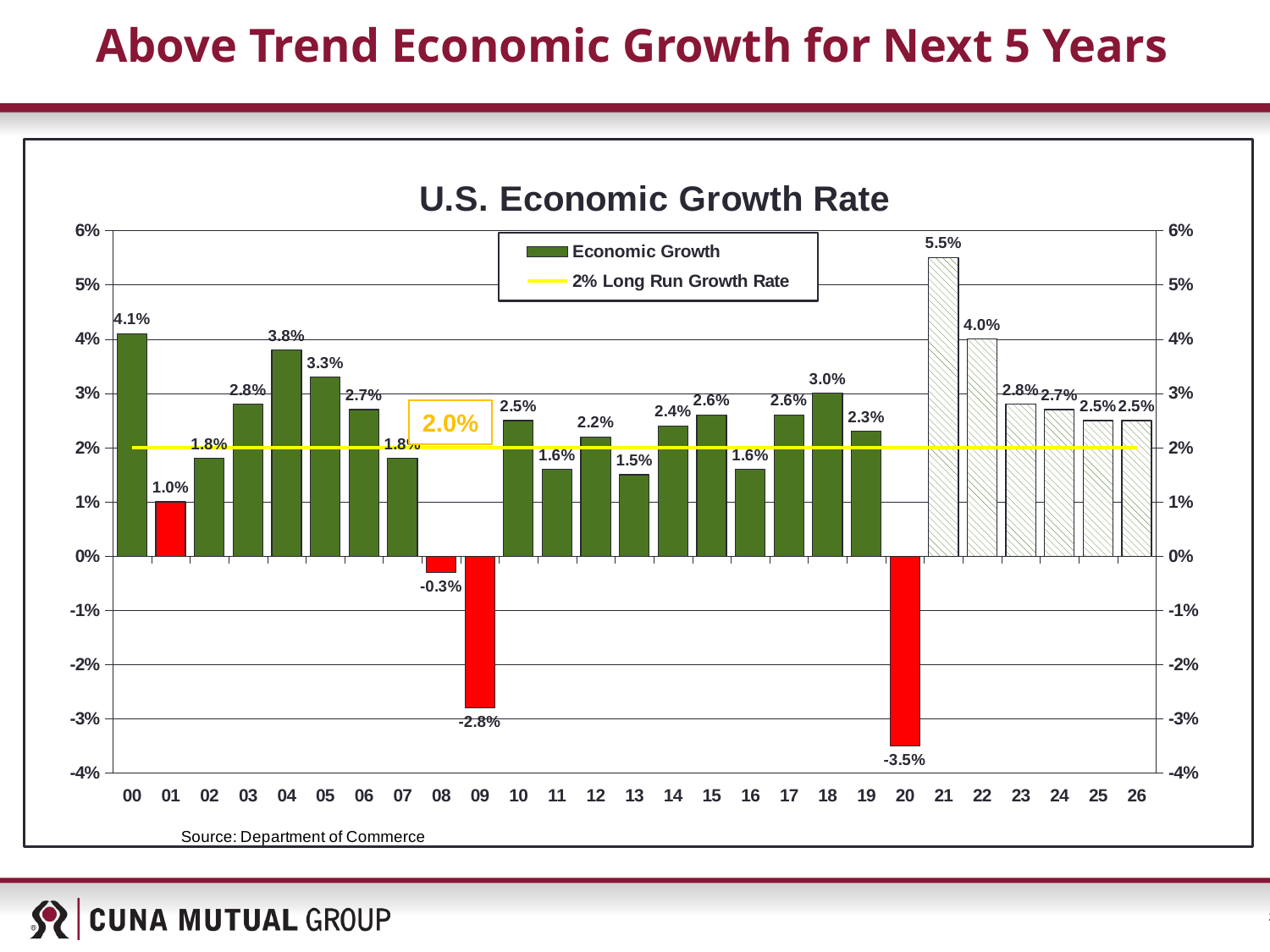
What value does the yellow horizontal line represent according to the legend? 2% Long Run Growth Rate Is the growth rate for 2000 (00) greater or less than 4%? greater What is the economic growth rate shown for 2009 (09)? -2.8% What is the economic growth rate shown for 2018 (18)? 3.0% How many series does the legend list? 2 What is the U.S. economic growth rate shown for 2021 (21)? 5.5% Which year has the highest economic growth rate on the chart? 21 What kind of chart is used to show the U.S. Economic Growth Rate? bar chart Which year has a higher growth rate, 2004 (04) or 2005 (05)? 04 How many years are plotted on the x axis of the chart? 27 What is the difference between the growth rate in 2021 (21) and in 2022 (22)? 1.5% Which year has the lowest economic growth rate on the chart? 20